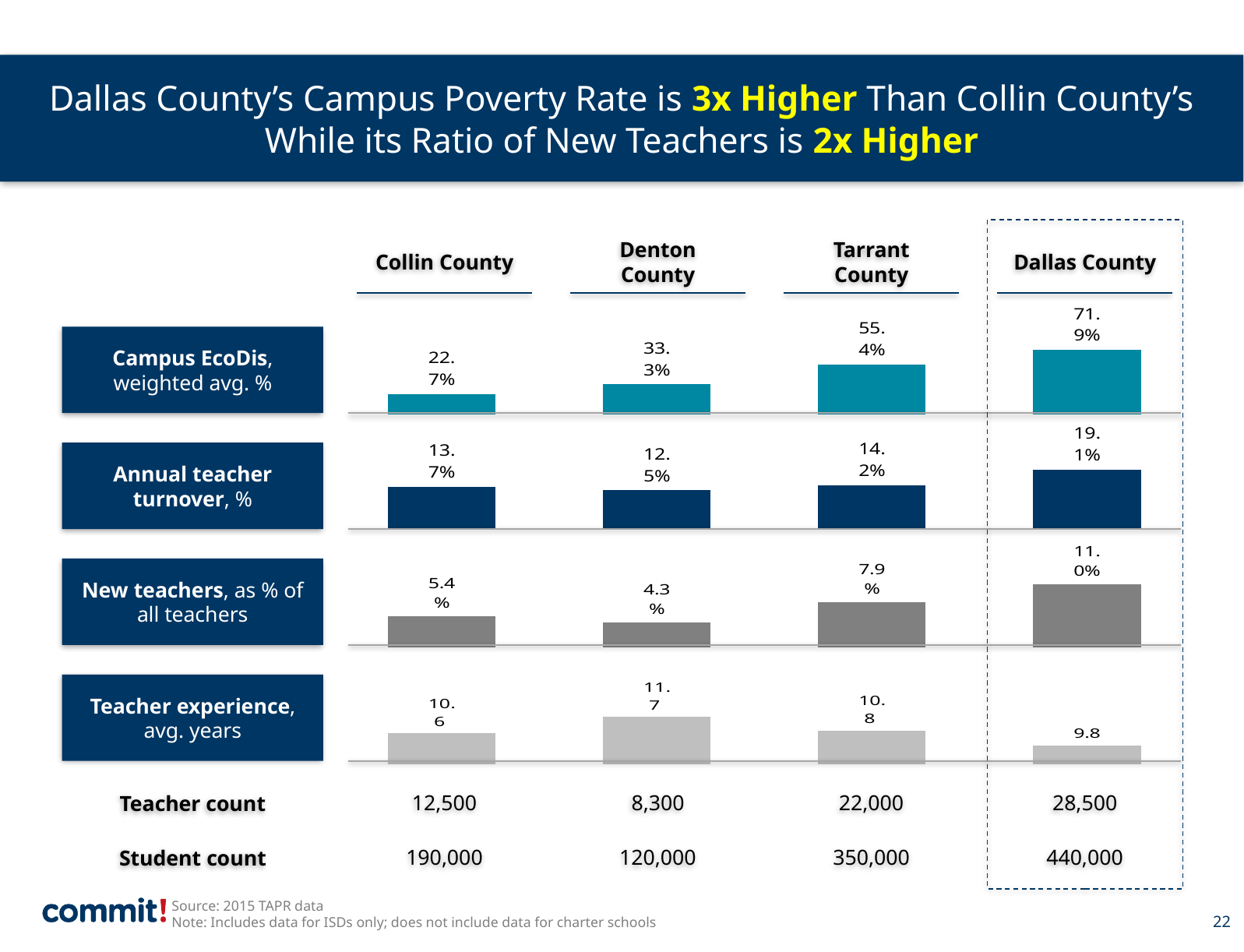
In the Teacher experience chart, what is the value for Dallas County? 9.8 In the Annual teacher turnover chart, which county has the lowest value? Denton County In the Campus EcoDis chart, do the values rise or fall from Collin County to Dallas County? rise In the Campus EcoDis chart, what is the value for Collin County? 22.7% In the Annual teacher turnover chart, which county has the highest value? Dallas County In the New teachers chart, what is the difference between Dallas County and Collin County? 5.6% In the Campus EcoDis chart, which is larger, Tarrant County or Denton County? Tarrant County What kind of chart is used for the Teacher experience row? bar chart In the Teacher experience chart, which county has the highest value? Denton County In the New teachers chart, what is the value for Tarrant County? 7.9% In the Campus EcoDis chart, what is the value for Dallas County? 71.9% How many counties are shown in the Annual teacher turnover chart? 4